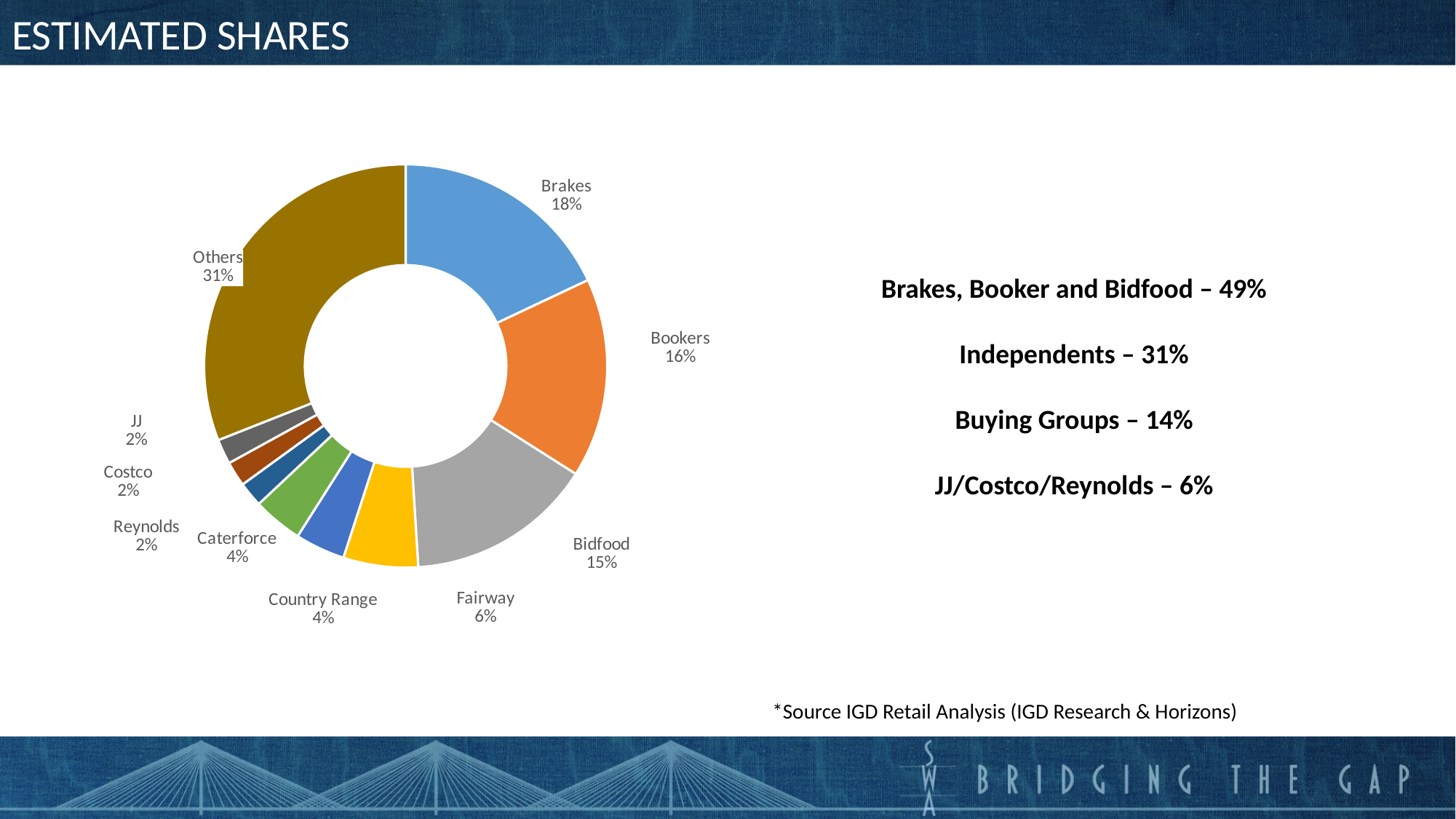
What is the title of the slide containing the chart? ESTIMATED SHARES Which named supplier (excluding Others) has the largest share in the pie chart? Brakes What share does Fairway have in the pie chart? 6% What is the difference in share between Others and Bidfood? 16% What share does Caterforce have in the pie chart? 4% Which category has the largest share in the pie chart? Others What is the difference in share between Brakes and Bookers? 2% What share does Brakes have in the pie chart? 18% What type of chart is shown on the slide? Pie chart (doughnut) How many categories are shown in the pie chart? 10 Which has a larger share, Bookers or Bidfood? Bookers What share does Bidfood have in the pie chart? 15%